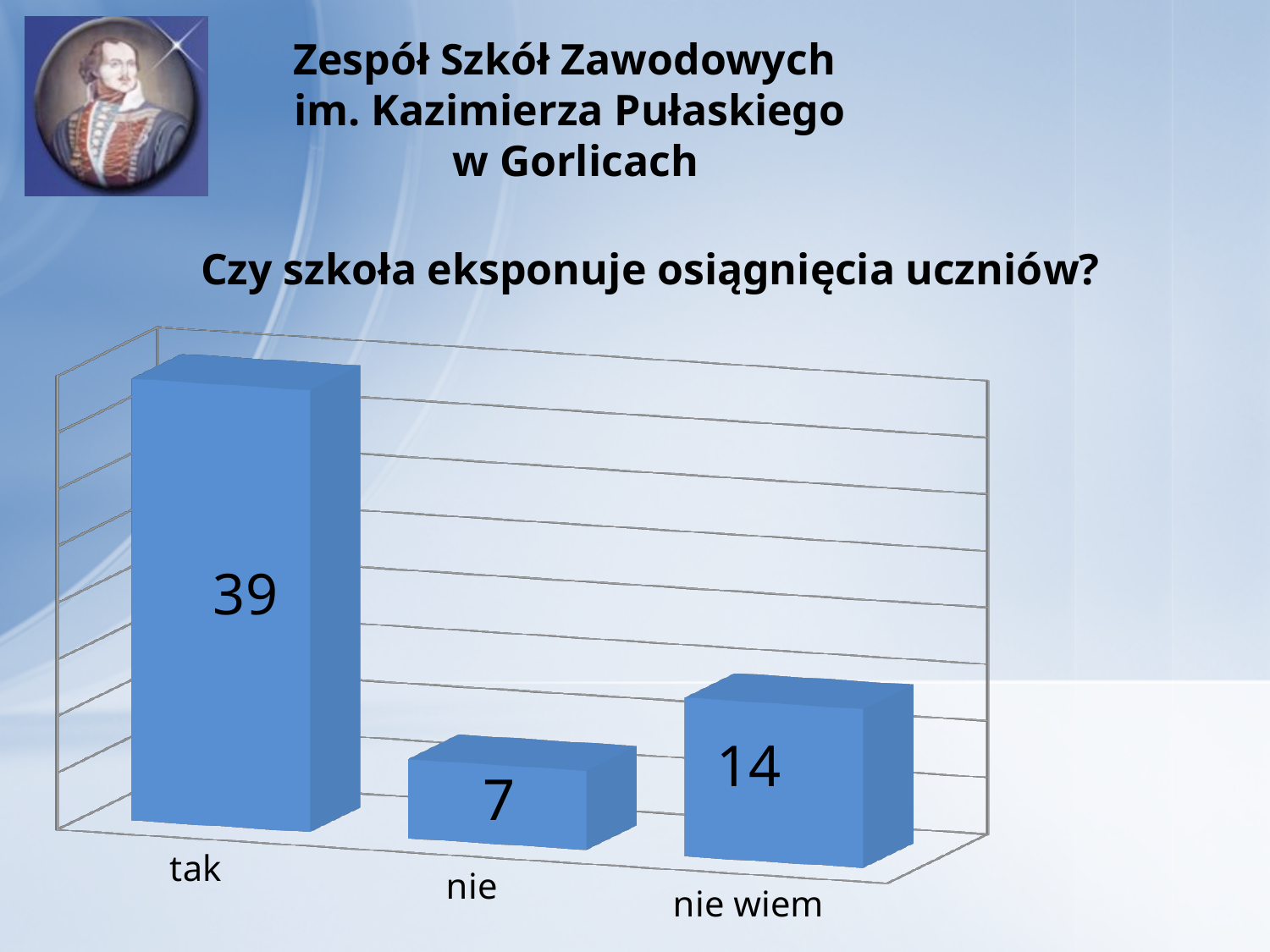
Which category has the highest value? tak Which is larger, the value for "nie" or the value for "nie wiem"? nie wiem What is the total of all three values in the chart? 60 What kind of chart is shown on the slide? bar chart What is the difference between the values for "nie wiem" and "nie"? 7 What is the value for "nie wiem"? 14 What is the value for "nie"? 7 What question is the chart titled with? Czy szkoła eksponuje osiągnięcia uczniów? What is the value for "tak"? 39 Which category has the lowest value? nie What is the difference between the values for "tak" and "nie wiem"? 25 How many categories are shown in the chart? 3